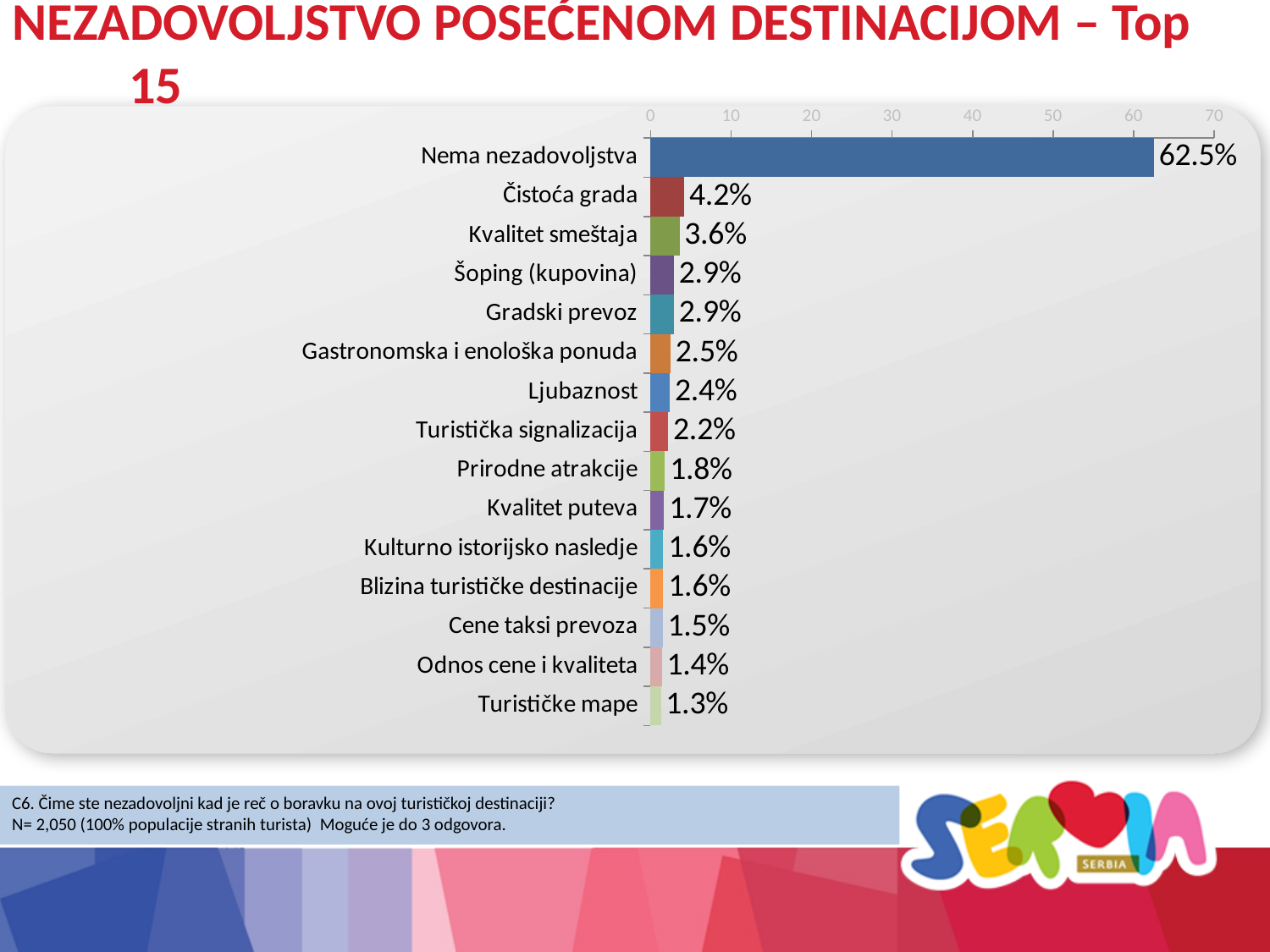
Which category has the lowest value? Turističke mape What is the difference between the values for Čistoća grada and Kvalitet smeštaja? 0.6% Which category has the highest value? Nema nezadovoljstva Which is larger, the value for Ljubaznost or the value for Prirodne atrakcije? Ljubaznost Is the value for Nema nezadovoljstva greater or less than 60? greater What is the value for Nema nezadovoljstva? 62.5% What kind of chart is shown on the slide? bar chart How many categories are shown in the chart? 15 What is the value for Kvalitet puteva? 1.7% What is the value for Turističke mape? 1.3% What is the value for Gastronomska i enološka ponuda? 2.5% What is the value for Čistoća grada? 4.2%